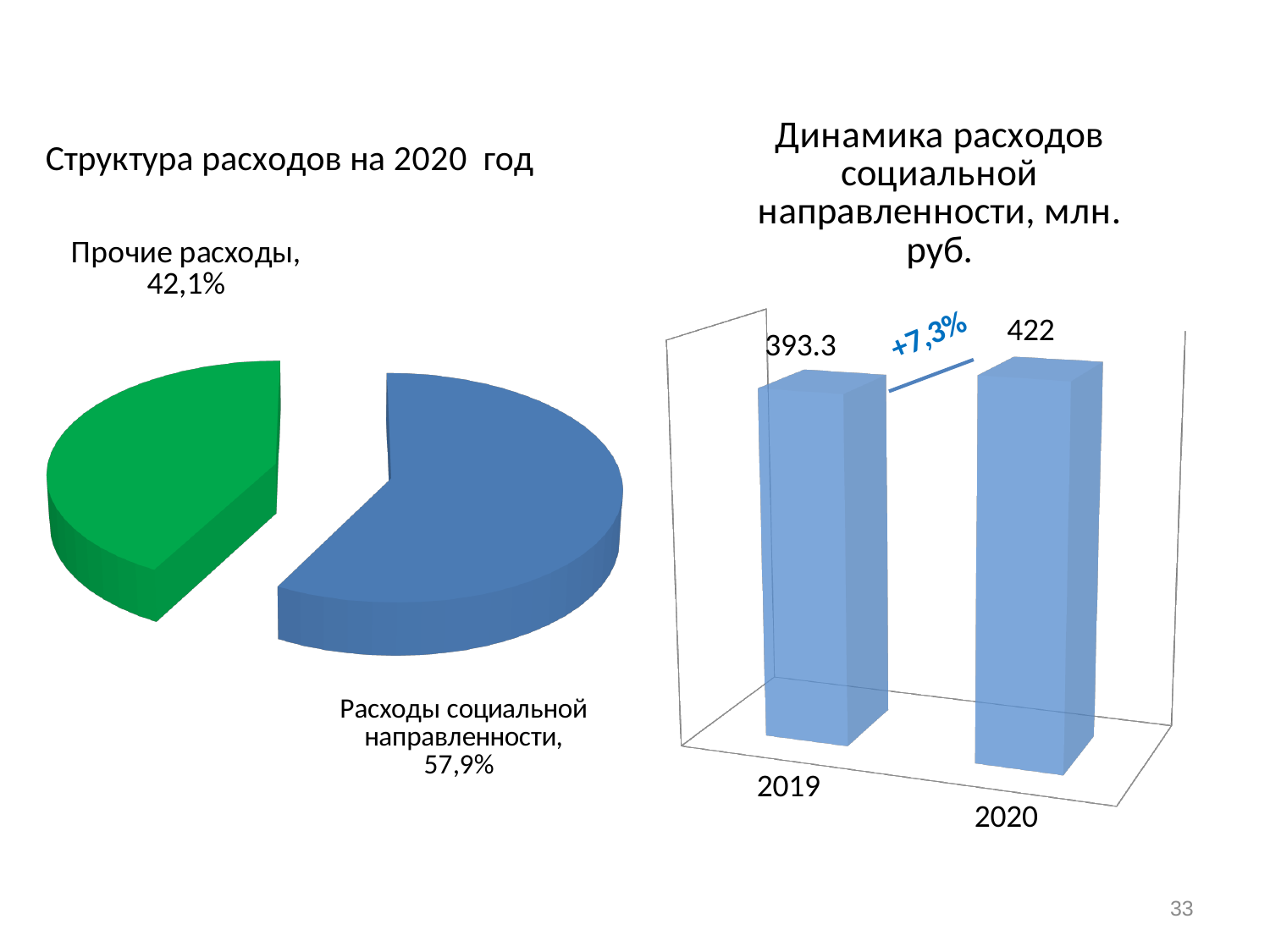
How many slices does the pie chart 'Структура расходов на 2020 год' have? 2 In the chart 'Динамика расходов социальной направленности, млн. руб.', what is the value for 2020? 422 In the chart 'Динамика расходов социальной направленности, млн. руб.', which year has the higher value? 2020 In the pie chart 'Структура расходов на 2020 год', what share is labelled for 'Прочие расходы'? 42,1% What type of chart is the chart on the right of the slide? Bar chart In the pie chart 'Структура расходов на 2020 год', what share is labelled for 'Расходы социальной направленности'? 57,9% What type of chart is the chart on the left of the slide? Pie chart In the chart 'Динамика расходов социальной направленности, млн. руб.', what is the value for 2019? 393.3 In the pie chart 'Структура расходов на 2020 год', which slice is larger: 'Прочие расходы' or 'Расходы социальной направленности'? Расходы социальной направленности In the pie chart 'Структура расходов на 2020 год', what colour is the 'Прочие расходы' slice? Green In the chart 'Динамика расходов социальной направленности, млн. руб.', do the values rise or fall from 2019 to 2020? Rise In the chart 'Динамика расходов социальной направленности, млн. руб.', what is the difference between the 2020 and 2019 values? 28.7